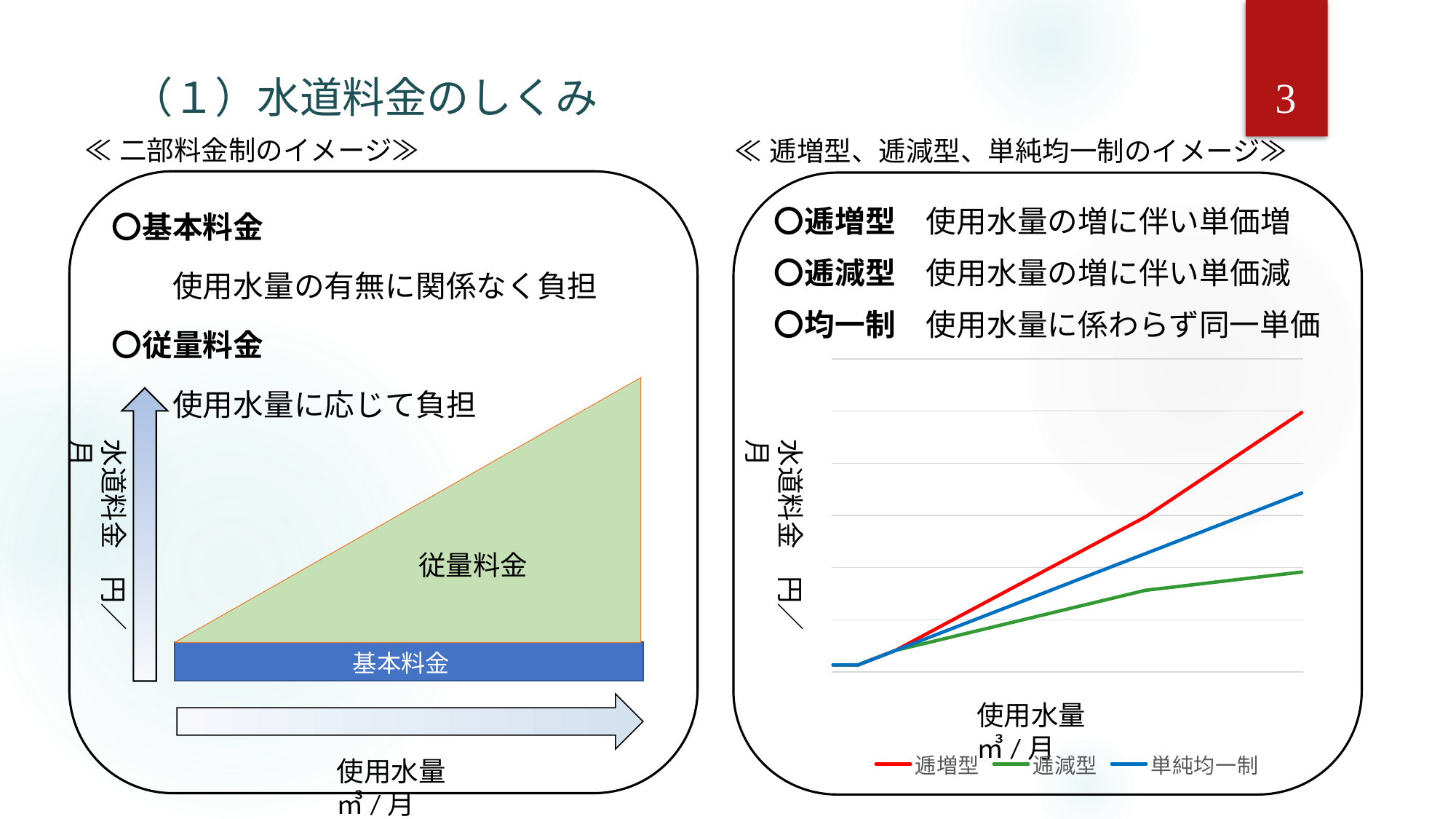
In the right-hand line chart, which series is plotted in green? 逓減型 In the right-hand line chart, which series reaches the highest value at the right end of the x axis? 逓増型 In the right-hand line chart, do the values of the 逓増型 series rise or fall as 使用水量 increases? rise In the right-hand line chart, at the right end of the x axis, which is larger: the value for 逓増型 or the value for 単純均一制? 逓増型 In the right-hand line chart, which series ends lowest at the right end of the x axis? 逓減型 What is the x-axis label of the right-hand line chart? 使用水量 ㎥/月 What kind of chart is shown on the right side of the slide? line chart In the right-hand line chart, which series is plotted in red? 逓増型 In the right-hand line chart, at the right end of the x axis, which is larger: the value for 単純均一制 or the value for 逓減型? 単純均一制 How many series does the legend of the right-hand line chart list? 3 In the right-hand line chart, do the values of the 逓減型 series rise or fall as 使用水量 increases? rise